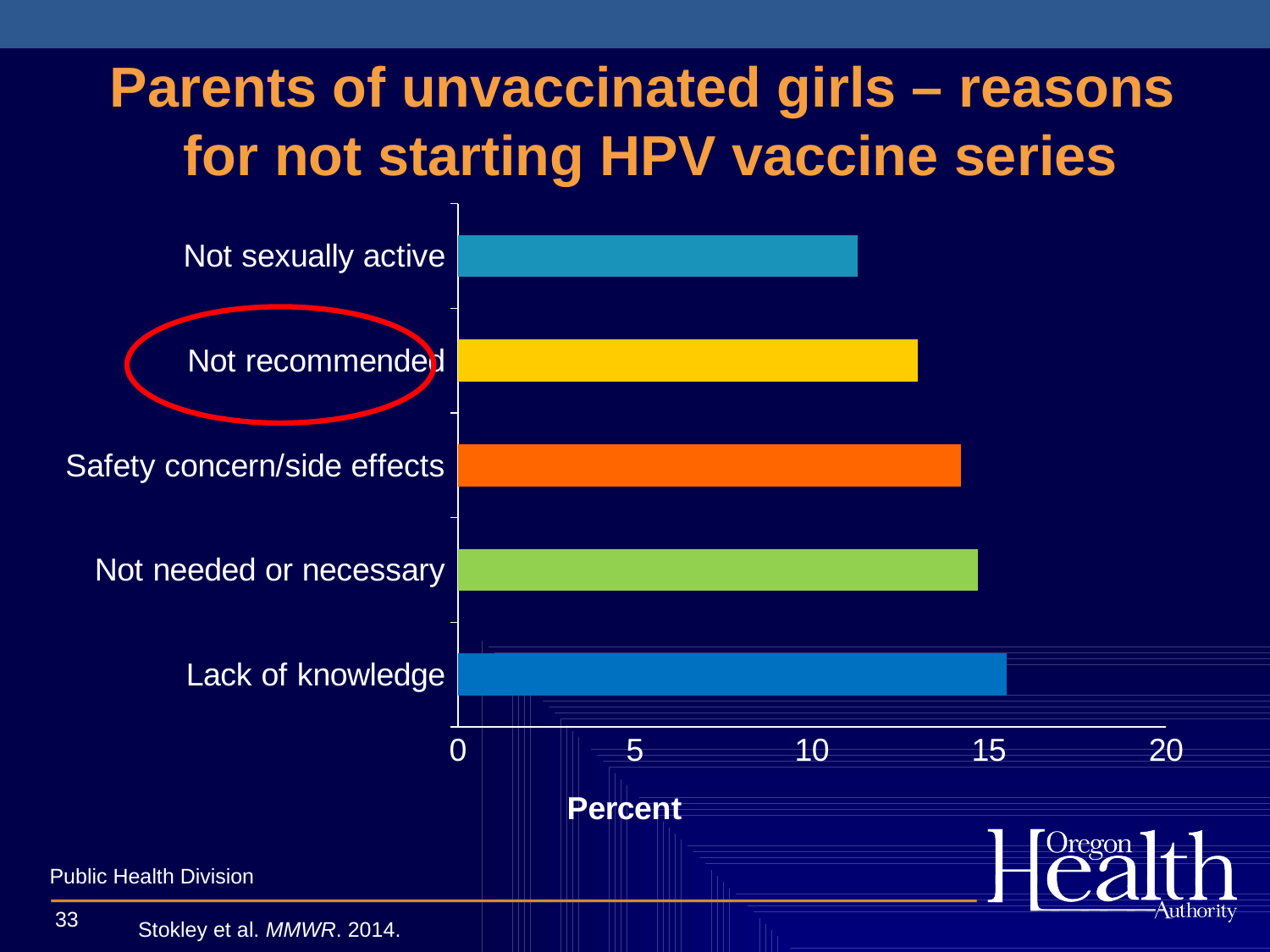
Which reason has the longest bar in the chart? Lack of knowledge Is the value for Lack of knowledge greater or less than 10? greater Which reason has the shortest bar in the chart? Not sexually active Is the value for Not sexually active greater or less than 10? greater Which is larger, the value for Not recommended or the value for Not needed or necessary? Not needed or necessary Which category label is circled in red on the chart? Not recommended How many reasons (categories) are plotted in the chart? 5 What kind of chart is shown on the slide? bar chart Is the value for Safety concern/side effects greater or less than 15? less What is the label on the horizontal axis of the chart? Percent Which is larger, the value for Safety concern/side effects or the value for Not sexually active? Safety concern/side effects